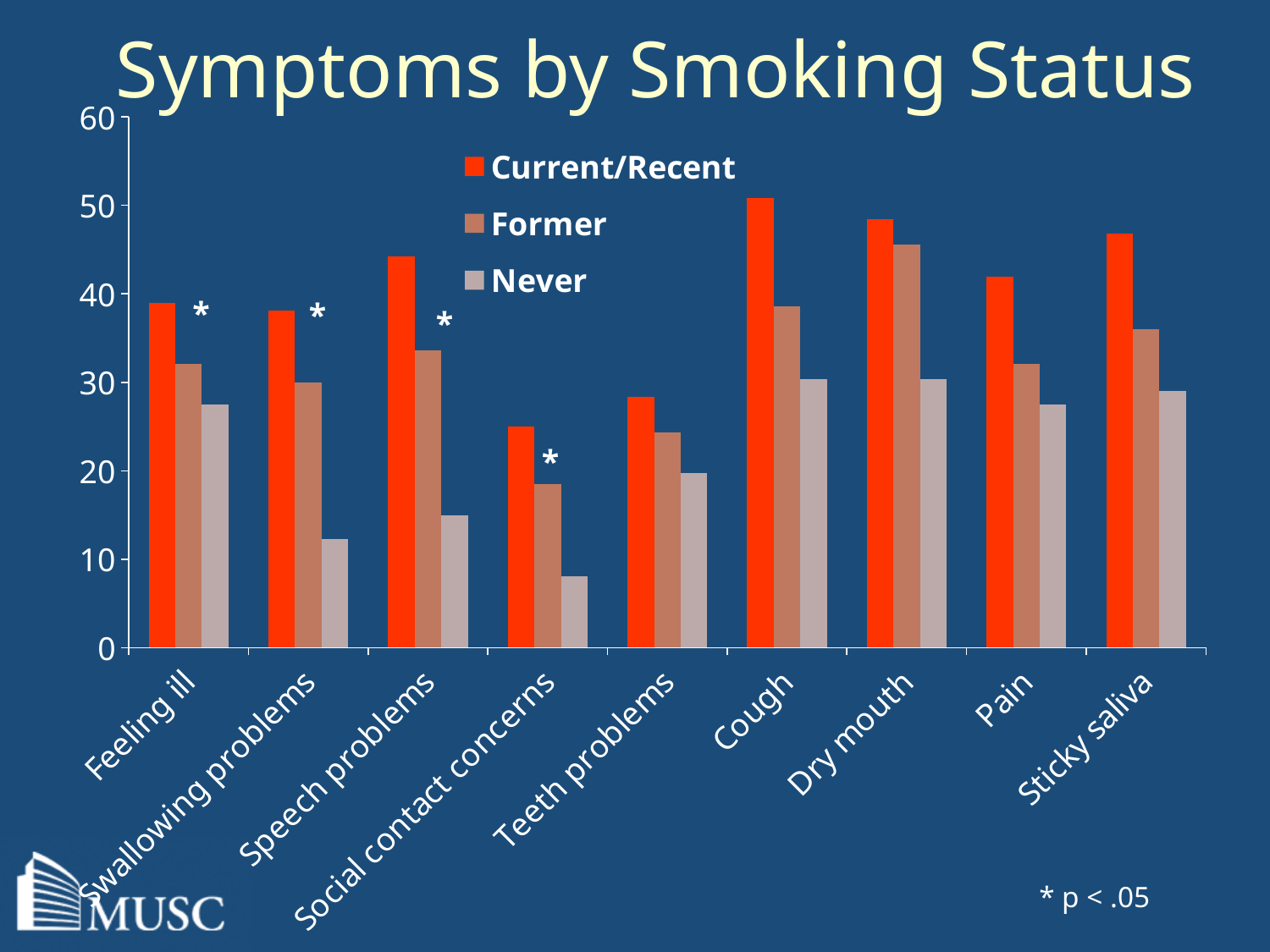
Is the Never value for Social contact concerns greater or less than 10? less Which symptom has the highest value for the Former series? Dry mouth What type of chart is shown on the slide? Bar chart What does the asterisk shown above some groups of bars indicate? p < .05 How many symptom categories are shown on the x axis? 9 Is the Never value for Swallowing problems greater or less than 20? less Which symptom has the highest value for the Current/Recent series? Cough Which symptom has the lowest value for the Current/Recent series? Social contact concerns Which symptom has the lowest value for the Never series? Social contact concerns How many series does the legend list? 3 For the Former series, which is larger: Speech problems or Teeth problems? Speech problems Is the Current/Recent value for Cough greater or less than 40? greater